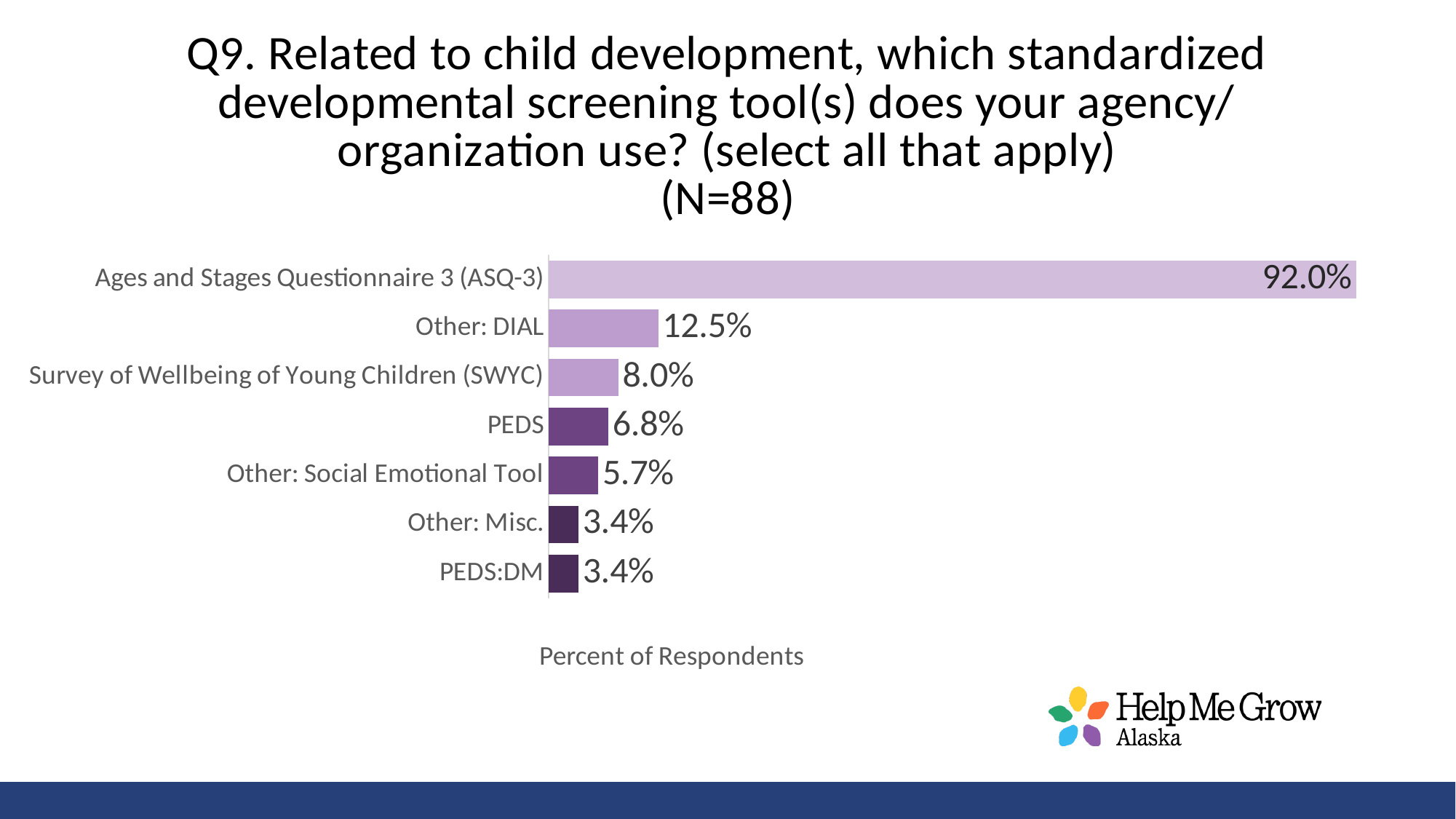
Which screening tool has the highest percentage of respondents? Ages and Stages Questionnaire 3 (ASQ-3) What percentage of respondents use the Survey of Wellbeing of Young Children (SWYC)? 8.0% How many screening tool categories are shown in the chart? 7 What is the value for PEDS? 6.8% What is the difference between the values for Ages and Stages Questionnaire 3 (ASQ-3) and Other: DIAL? 79.5% What is the value for Other: DIAL? 12.5% What is the difference between the values for PEDS and PEDS:DM? 3.4% What is the value for Other: Social Emotional Tool? 5.7% Which is larger, the value for Survey of Wellbeing of Young Children (SWYC) or the value for PEDS? Survey of Wellbeing of Young Children (SWYC) What percentage of respondents use the Ages and Stages Questionnaire 3 (ASQ-3)? 92.0% What kind of chart is shown on the slide? Bar chart What is the label on the horizontal axis of the chart? Percent of Respondents